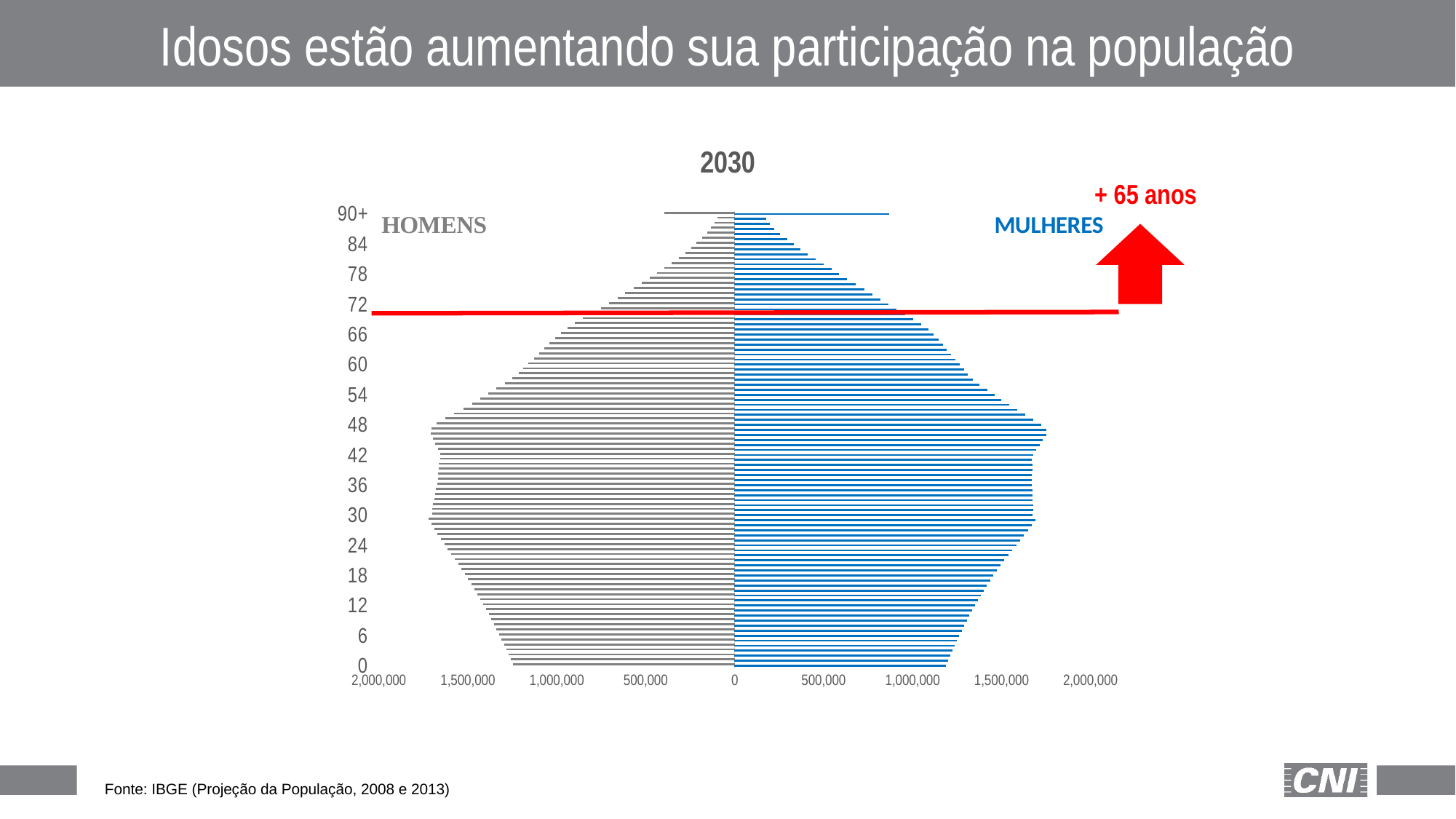
At age 90+, which group has the larger value, HOMENS or MULHERES? MULHERES Do the bars for HOMENS get longer or shorter as age increases from 48 to 90+? Shorter Is the value for HOMENS at age 90+ greater or less than 500,000? less Which colour represents MULHERES in the chart? Blue What is the title of the chart? 2030 Is the value for HOMENS at age 0 greater or less than 1,000,000? greater Is the value for MULHERES at age 78 greater or less than 1,000,000? less Which two groups are plotted in the chart? HOMENS and MULHERES What kind of chart is shown on the slide? Bar chart (population pyramid) What is the highest value shown on the horizontal axis? 2,000,000